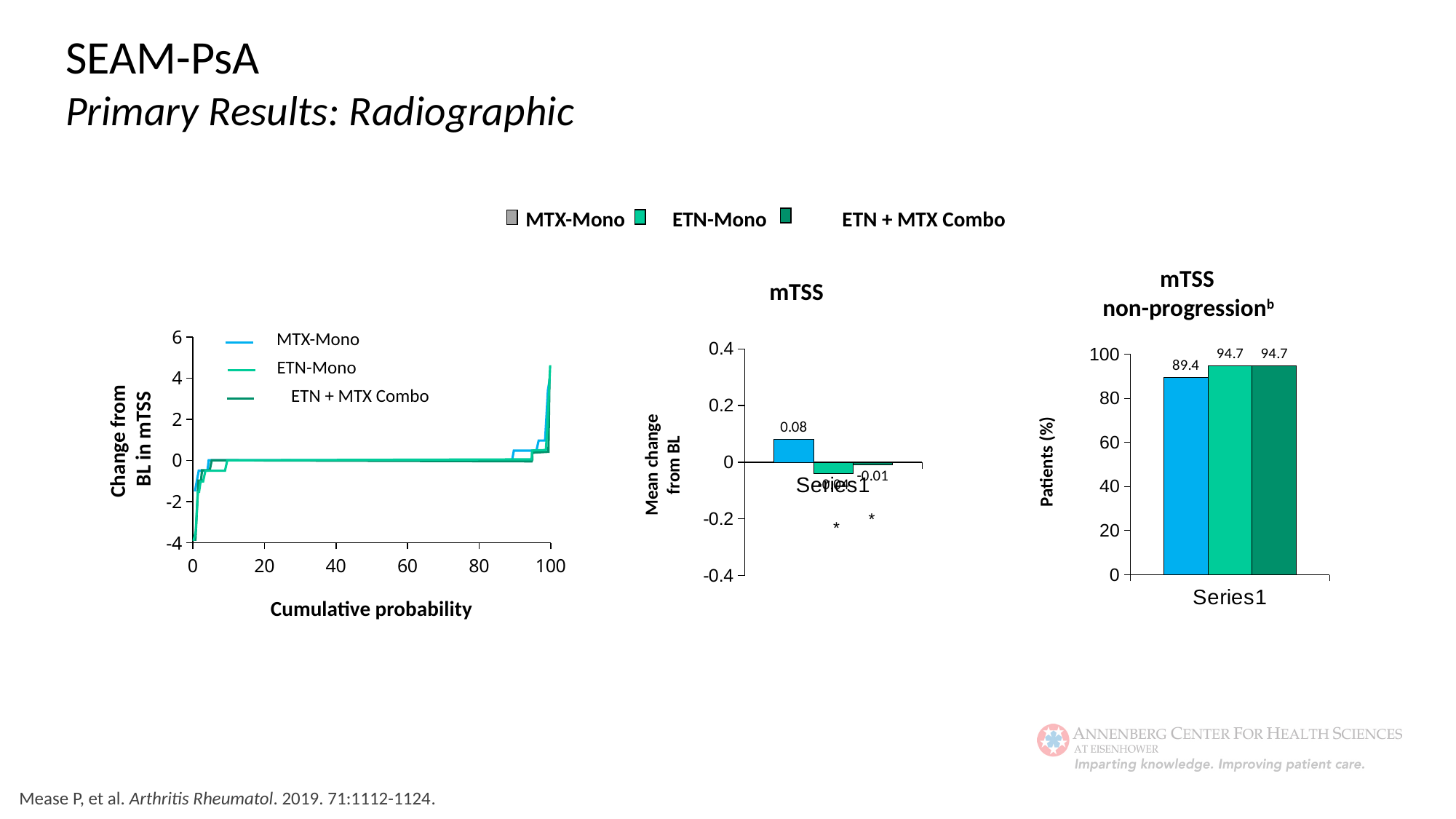
In the mTSS non-progression chart, which group has the lowest percentage of patients? MTX-Mono In the mTSS non-progression chart, what percentage of patients is shown for MTX-Mono? 89.4 What kind of chart is the left chart showing change from BL in mTSS against cumulative probability? line chart In the mTSS non-progression chart, what percentage of patients is shown for ETN + MTX Combo? 94.7 In the mTSS chart (middle), what is the mean change from baseline for ETN + MTX Combo? -0.01 In the mTSS non-progression chart, what percentage of patients is shown for ETN-Mono? 94.7 In the mTSS non-progression chart, how many bars are plotted? 3 In the mTSS chart (middle), which group has the highest mean change from baseline? MTX-Mono In the mTSS chart (middle), what is the mean change from baseline for MTX-Mono? 0.08 In the mTSS non-progression chart, is the value for MTX-Mono greater or less than 80? greater How many series does the legend of the left cumulative probability chart list? 3 In the mTSS non-progression chart, what is the difference between the ETN-Mono and MTX-Mono values? 5.3